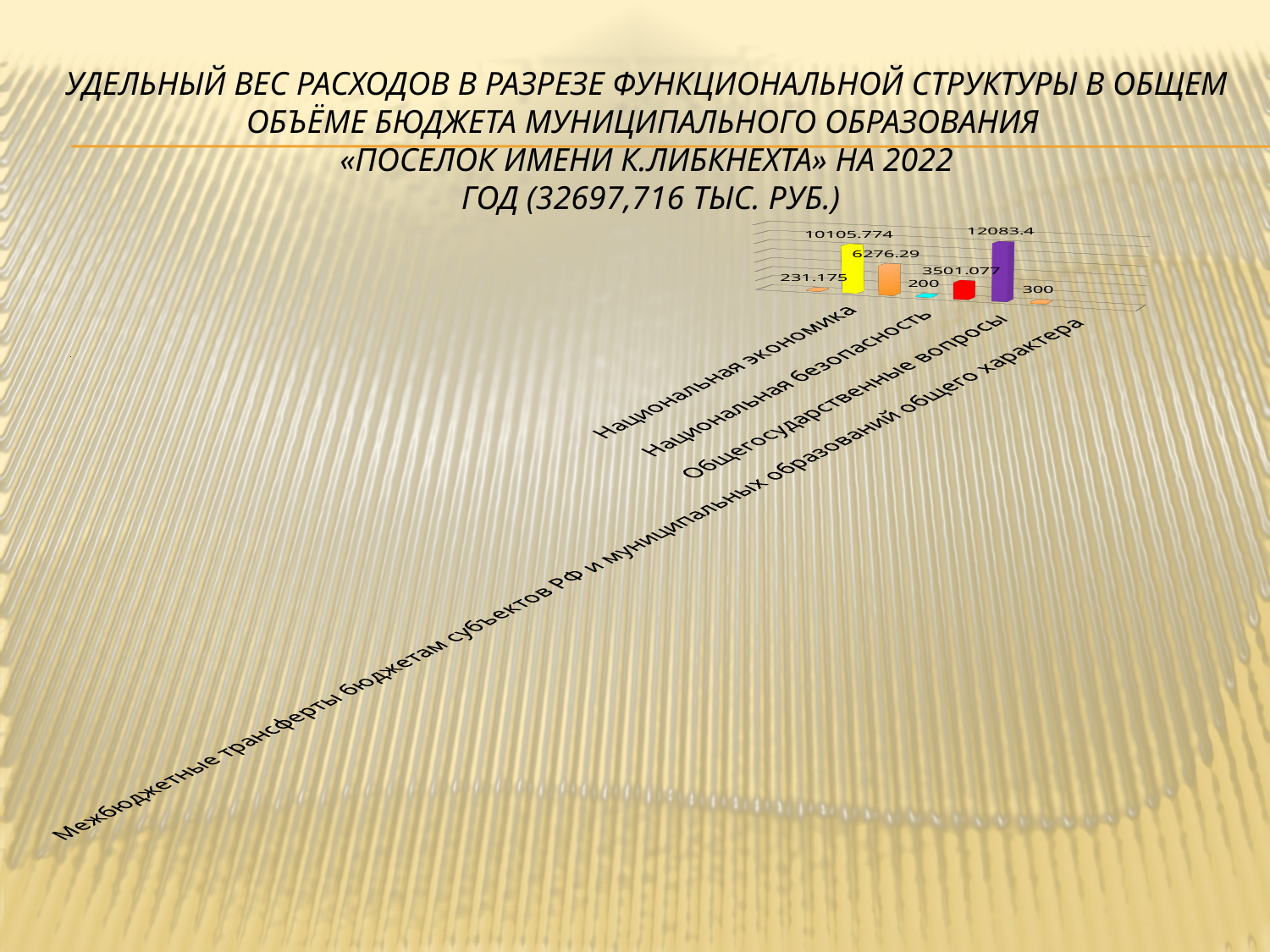
What is the difference between the labelled values 300 and 200? 100 Which is larger, the orange bar's value of 6276.29 or the red bar's value of 3501.077? 6276.29 What value is labelled on the tall purple bar? 12083.4 What is the lowest value labelled in the chart? 200 What value is labelled on the orange bar next to the yellow one? 6276.29 What kind of chart is shown on the slide? bar chart What value is labelled on the yellow bar? 10105.774 According to the chart title, what is the total budget volume for 2022? 32697,716 тыс. руб. What value is labelled on the red bar? 3501.077 How many bars are plotted in the chart? 7 What is the difference between the two largest labelled values, 12083.4 and 10105.774? 1977.626 What is the highest value labelled in the chart? 12083.4